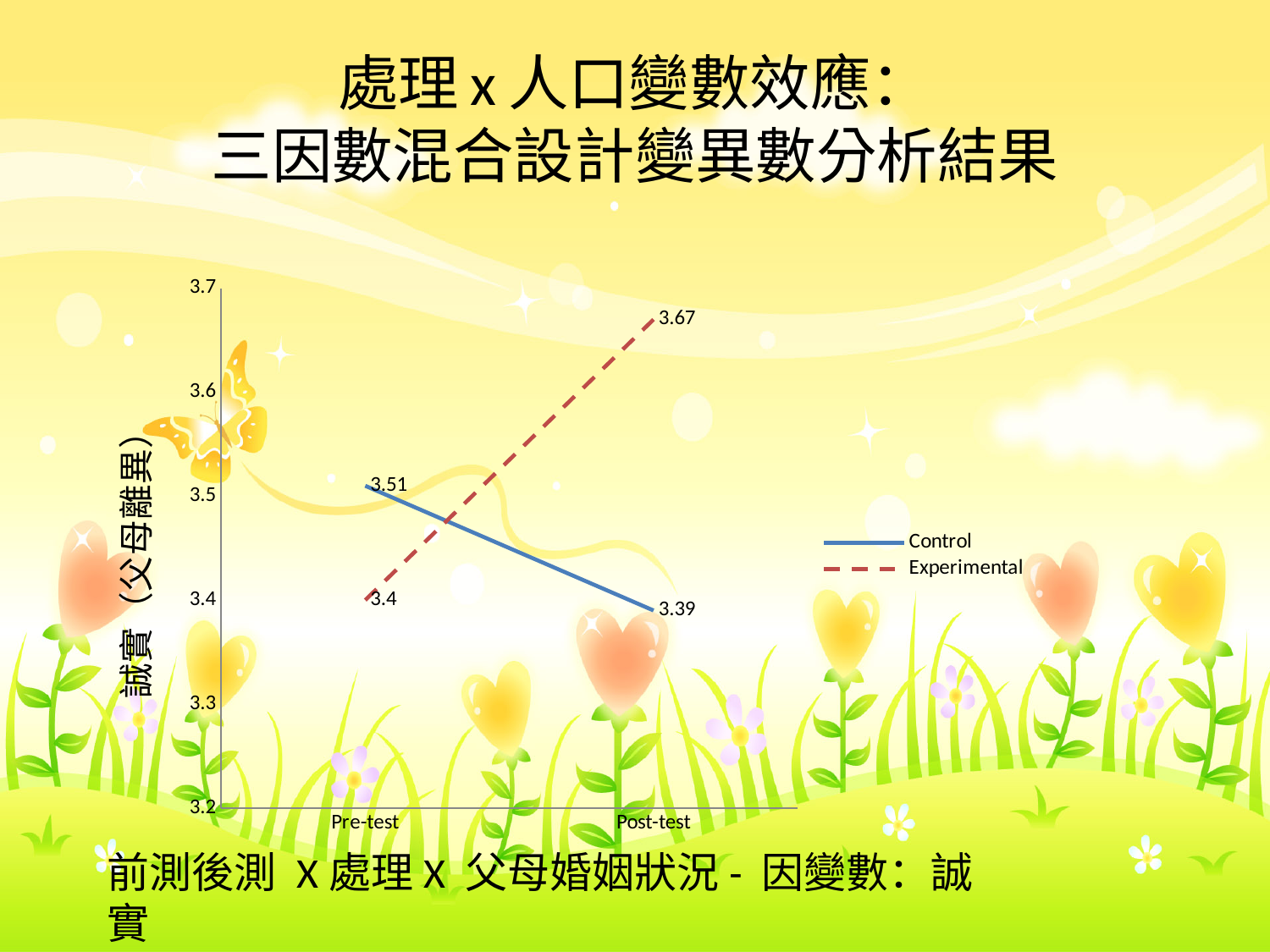
Does the Control series rise or fall from Pre-test to Post-test? fall What is the difference between the Experimental Post-test and Pre-test values? 0.27 How many series does the legend list? 2 What is the Experimental value at Pre-test? 3.4 What is the Experimental value at Post-test? 3.67 Does the Experimental series rise or fall from Pre-test to Post-test? rise Which series has the higher value at Post-test? Experimental Which series has the higher value at Pre-test? Control What is the Control value at Post-test? 3.39 What kind of chart is shown on the slide? line chart What is the Control value at Pre-test? 3.51 What is the difference between the Control Pre-test and Post-test values? 0.12